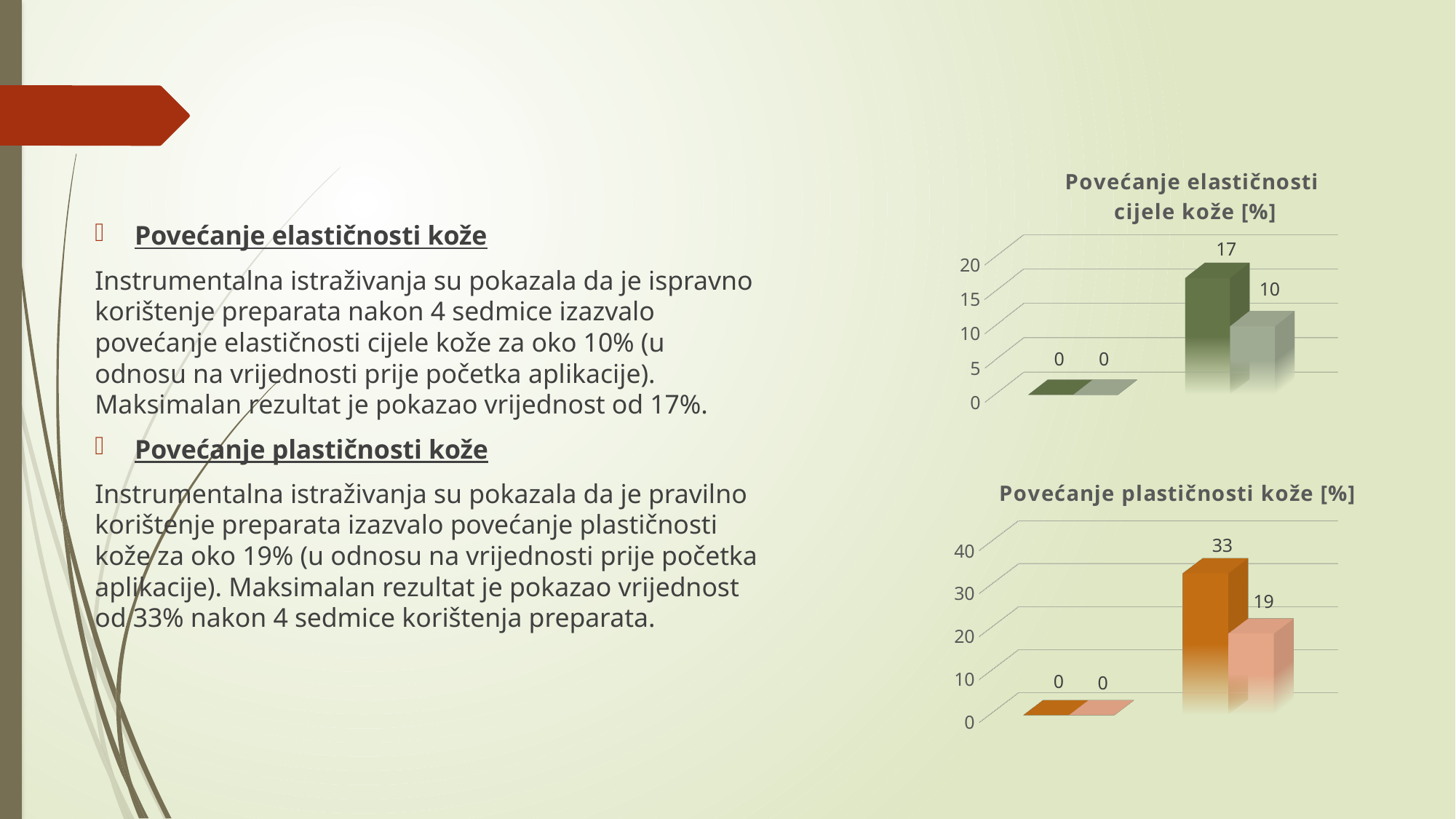
What kind of chart is the chart titled "Povećanje plastičnosti kože [%]"? bar chart In the chart titled "Povećanje plastičnosti kože [%]", what is the difference between the two bars in the second group (33 and 19)? 14 In the chart titled "Povećanje elastičnosti cijele kože [%]", what is the value of the lighter grey bar in the second group? 10 In the chart titled "Povećanje elastičnosti cijele kože [%]", what values are labelled on the two bars in the first group? 0 and 0 In the chart titled "Povećanje plastičnosti kože [%]", which bar in the second group is larger, the dark orange one or the light pink one? the dark orange one In the chart titled "Povećanje elastičnosti cijele kože [%]", what is the difference between the two bars in the second group (17 and 10)? 7 In the chart titled "Povećanje plastičnosti kože [%]", what is the value of the dark orange bar in the second group? 33 In the chart titled "Povećanje plastičnosti kože [%]", what is the value of the light pink bar in the second group? 19 In the chart titled "Povećanje plastičnosti kože [%]", what is the highest value on the vertical axis? 40 What kind of chart is the chart titled "Povećanje elastičnosti cijele kože [%]"? bar chart How many charts are shown on the slide? 2 In the chart titled "Povećanje elastičnosti cijele kože [%]", what is the highest value shown by a data label? 17